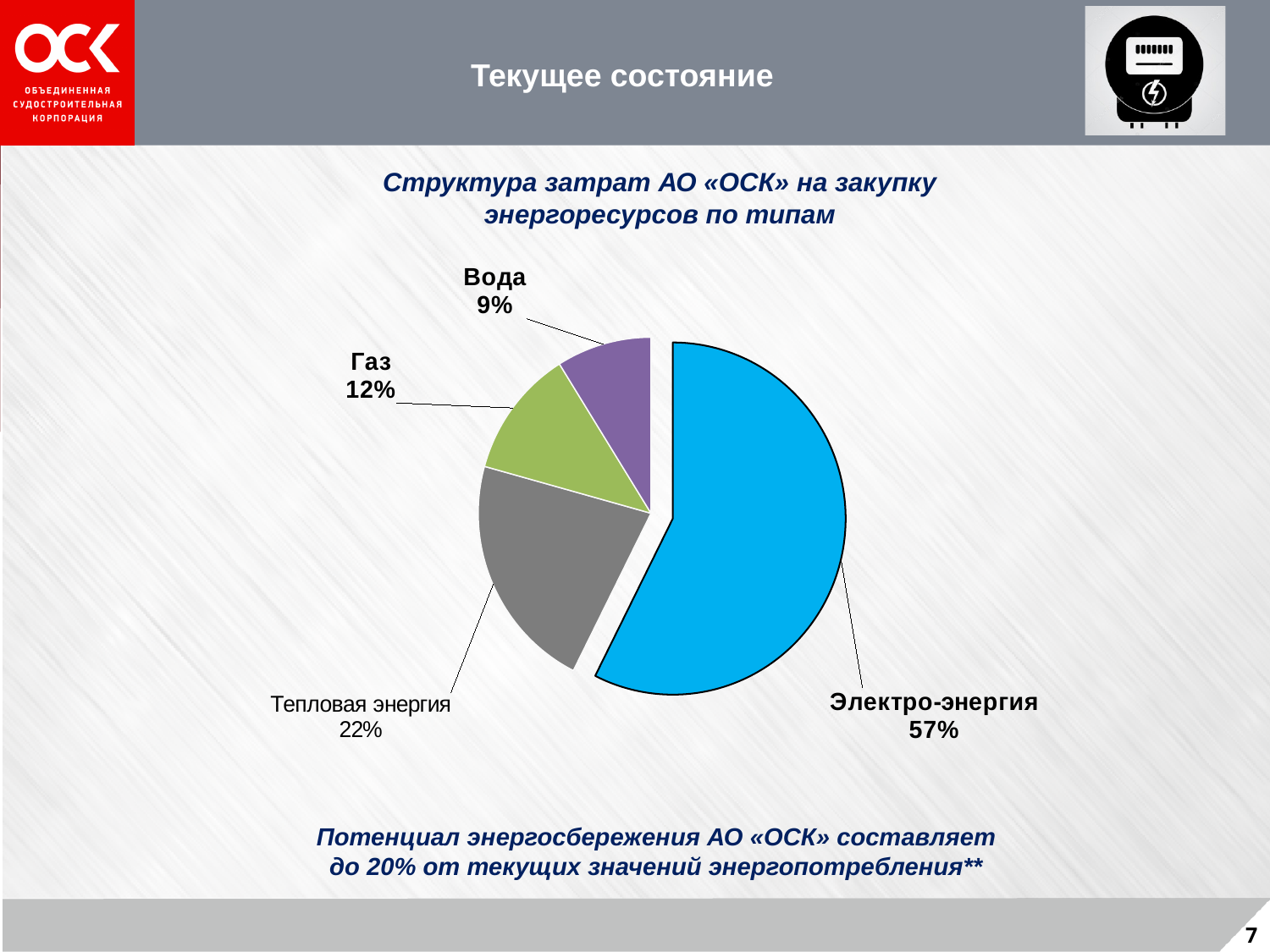
What share of the pie does Тепловая энергия have? 22% What is the title of the chart? Структура затрат АО «ОСК» на закупку энергоресурсов по типам How many categories are shown in the pie chart? 4 Which category has the largest share of the pie? Электро-энергия What is the difference between the shares of Электро-энергия and Тепловая энергия? 35% What is the value shown for Газ? 12% Which category has the smallest share of the pie? Вода What is the difference between the shares of Газ and Вода? 3% Which is larger, the share of Тепловая энергия or the share of Газ? Тепловая энергия What kind of chart is shown on the slide? Pie chart What share of the pie does Электро-энергия have? 57% What is the value shown for Вода? 9%